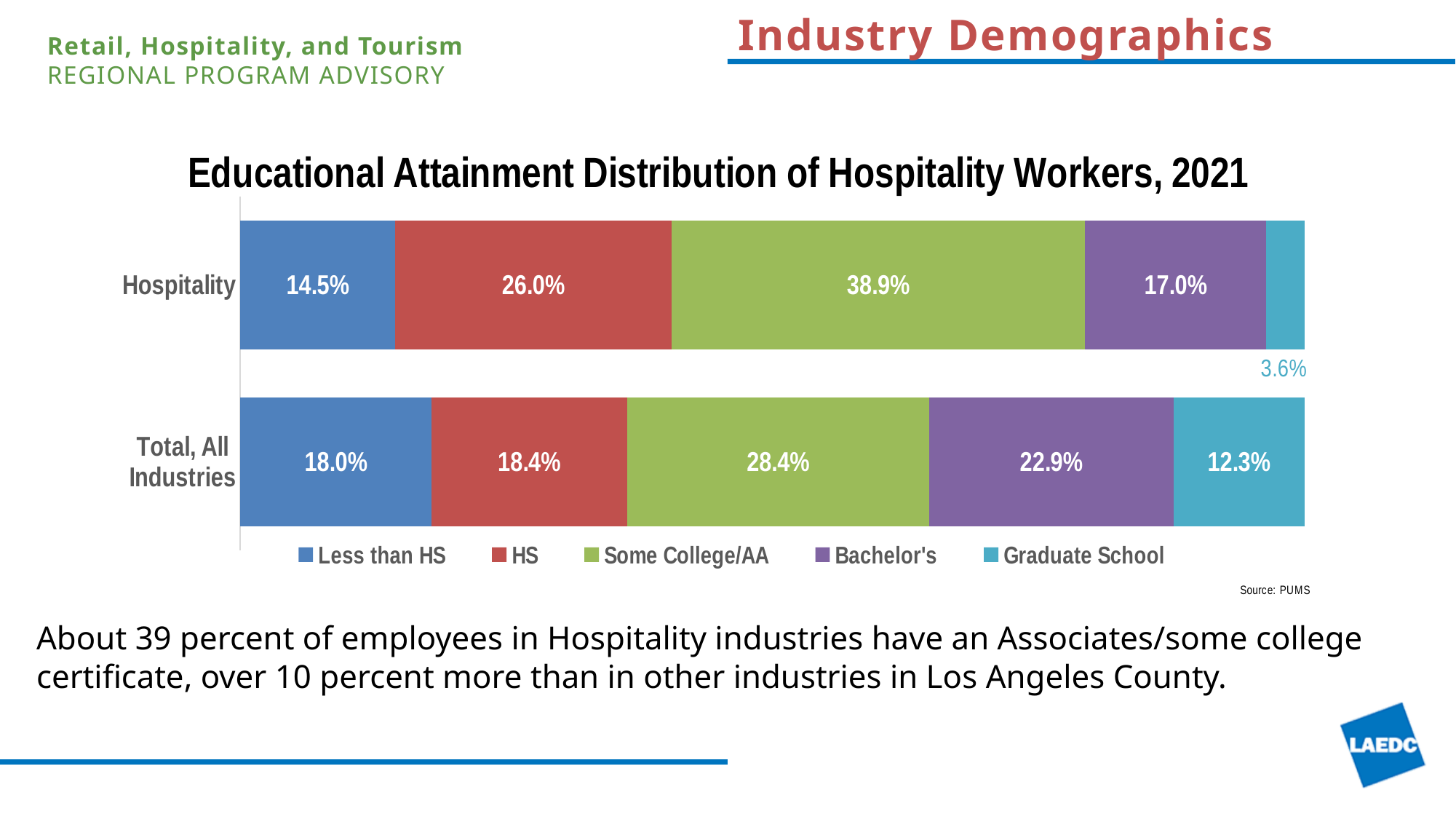
Which has a larger HS share, Hospitality or Total, All Industries? Hospitality What is the Graduate School share for Hospitality workers? 3.6% What is the difference between the Some College/AA share for Hospitality and for Total, All Industries? 10.5% What is the Less than HS share for Total, All Industries? 18.0% What is the title of the chart? Educational Attainment Distribution of Hospitality Workers, 2021 Which has a larger Graduate School share, Hospitality or Total, All Industries? Total, All Industries How many series does the legend list? 5 What kind of chart is shown on the slide? Stacked bar chart Which educational attainment category has the largest share among Hospitality workers? Some College/AA Which educational attainment category has the smallest share for Total, All Industries? Graduate School What is the Bachelor's share for Total, All Industries? 22.9% What share of Hospitality workers have Some College/AA? 38.9%